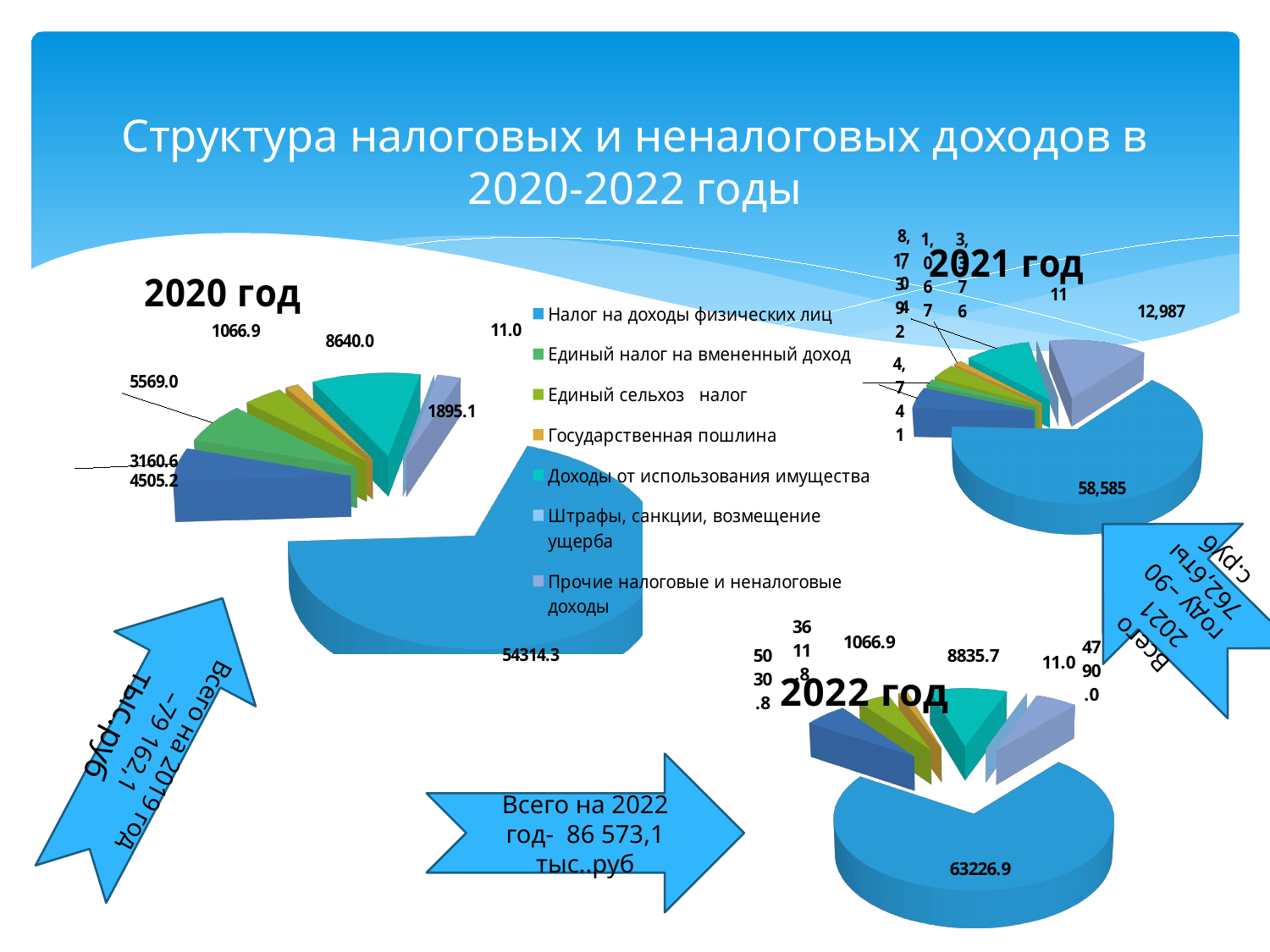
In the 2021 год chart, what value is labelled on the largest slice? 58,585 How many pie charts are shown on the slide? 3 In the 2020 год chart, what value is labelled on the teal slice (Доходы от использования имущества)? 8640.0 In the 2022 год chart, what value is labelled on the largest slice? 63226.9 What is the difference between the largest slice of the 2022 год chart (63226.9) and the largest slice of the 2020 год chart (54314.3)? 8912.6 In the 2022 год chart, what value is labelled on the teal slice (Доходы от использования имущества)? 8835.7 Which legend entry is shown in dark blue, the colour of the largest slice in each chart? Налог на доходы физических лиц In the 2020 год chart, what value is labelled on the largest slice? 54314.3 How many entries does the shared legend list? 7 Which chart has the larger value on its biggest slice, 2020 год or 2022 год? 2022 год In the 2020 год chart, what is the smallest value labelled on the chart? 11.0 What kind of chart is used for the 2020 год data? pie chart